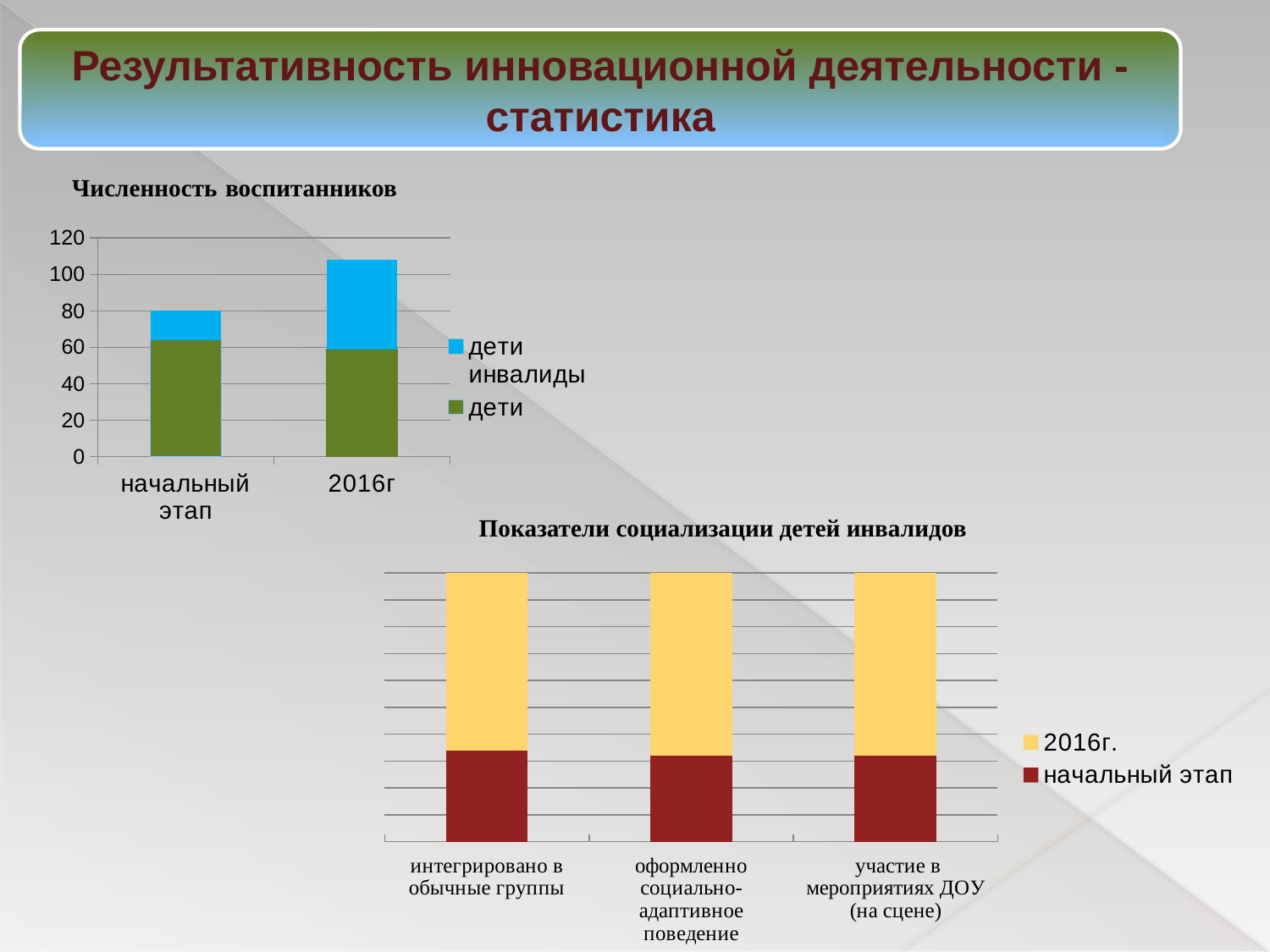
In the chart titled "Численность воспитанников", what kind of chart is shown? bar chart In the chart titled "Численность воспитанников", is the total height of the stacked bar for 2016г greater or less than 100? greater In the chart titled "Показатели социализации детей инвалидов", how many categories are shown on the x axis? 3 In the chart titled "Численность воспитанников", which series is shown in blue? дети инвалиды In the chart titled "Показатели социализации детей инвалидов", what kind of chart is shown? bar chart In the chart titled "Показатели социализации детей инвалидов", how many series does the legend list? 2 In the chart titled "Численность воспитанников", is the value of "дети" for начальный этап greater or less than 40? greater In the chart titled "Численность воспитанников", is the value of "дети инвалиды" for начальный этап greater or less than 40? less In the chart titled "Численность воспитанников", how many categories are shown on the x axis? 2 In the chart titled "Показатели социализации детей инвалидов", which series is shown in dark red? начальный этап In the chart titled "Численность воспитанников", which category has the taller stacked bar, начальный этап or 2016г? 2016г In the chart titled "Численность воспитанников", how many series does the legend list? 2